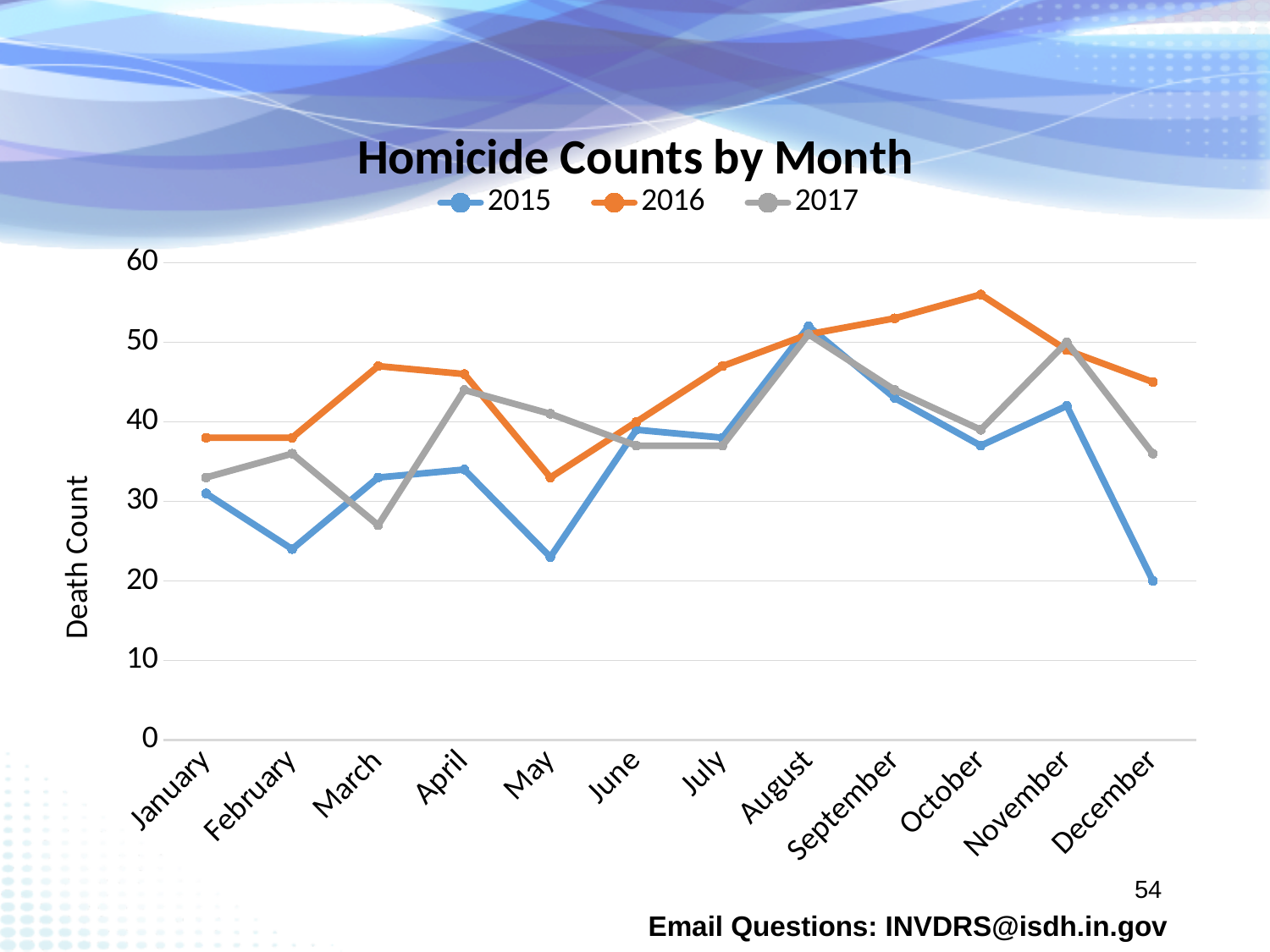
Is the 2017 value for March greater or less than 30? less In March, which series has the larger value, 2015 or 2016? 2016 What is the title of the chart? Homicide Counts by Month How many series does the legend list? 3 Does the 2015 series rise or fall from November to December? fall In which month does the 2016 series reach its highest value? October In April, which series has the larger value, 2015 or 2017? 2017 What kind of chart is shown on the slide? line chart How many months are shown along the x axis? 12 Is the 2016 value for October greater or less than 50? greater In which month does the 2015 series reach its lowest value? December Is the 2015 value for May greater or less than 30? less